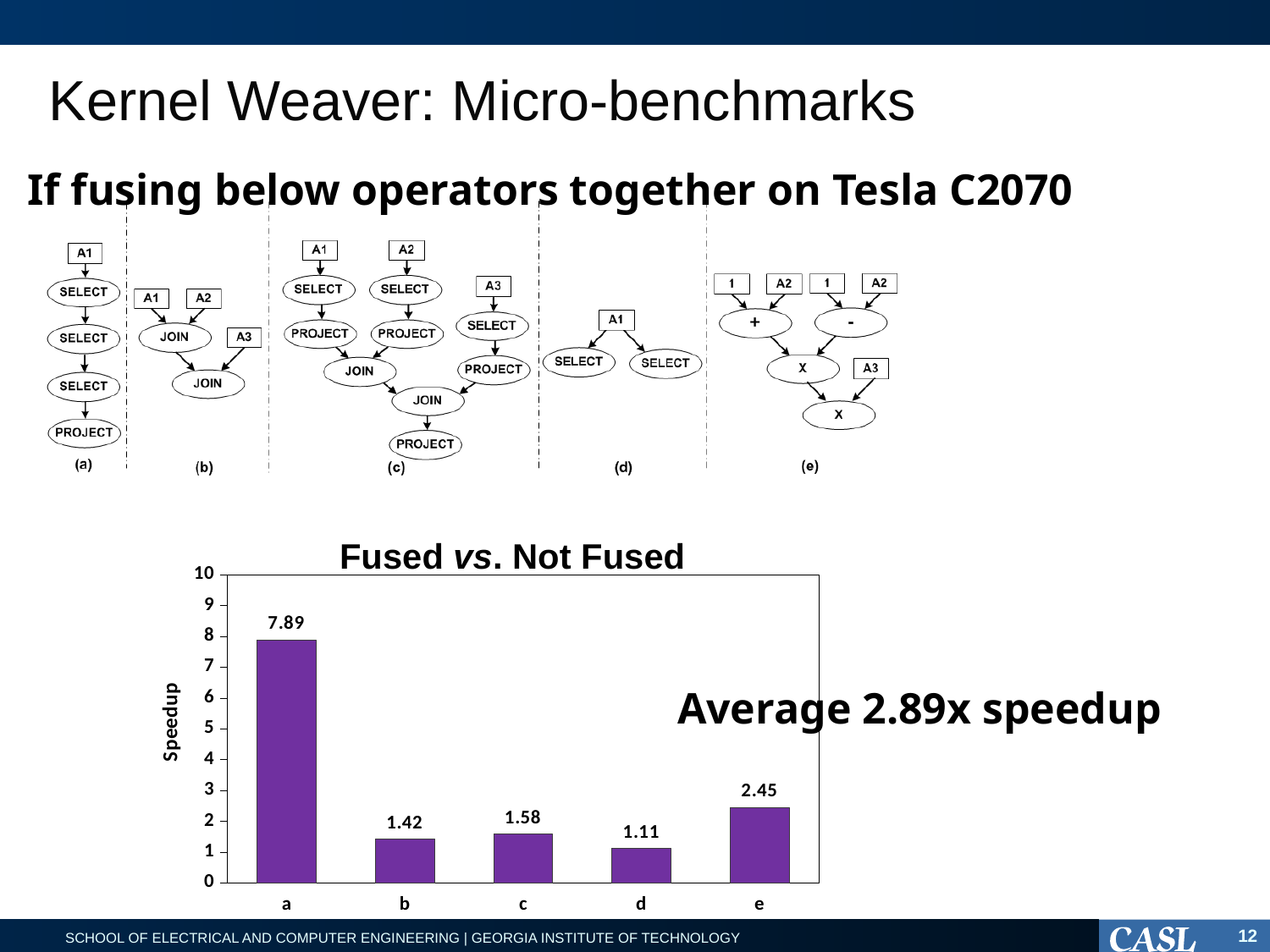
What is the speedup for benchmark e in the Fused vs. Not Fused chart? 2.45 Which benchmark has the lowest speedup? d What is the speedup for benchmark a in the Fused vs. Not Fused chart? 7.89 Is the speedup for benchmark a greater or less than 7? greater Which has a larger speedup, benchmark b or benchmark c? c Which benchmark has the highest speedup? a What is the difference between the speedup for a and the speedup for e? 5.44 What is the difference between the speedup for c and the speedup for b? 0.16 What is the speedup for benchmark d? 1.11 What kind of chart is shown on the slide? bar chart How many benchmarks are plotted in the chart? 5 What is the title of the chart? Fused vs. Not Fused